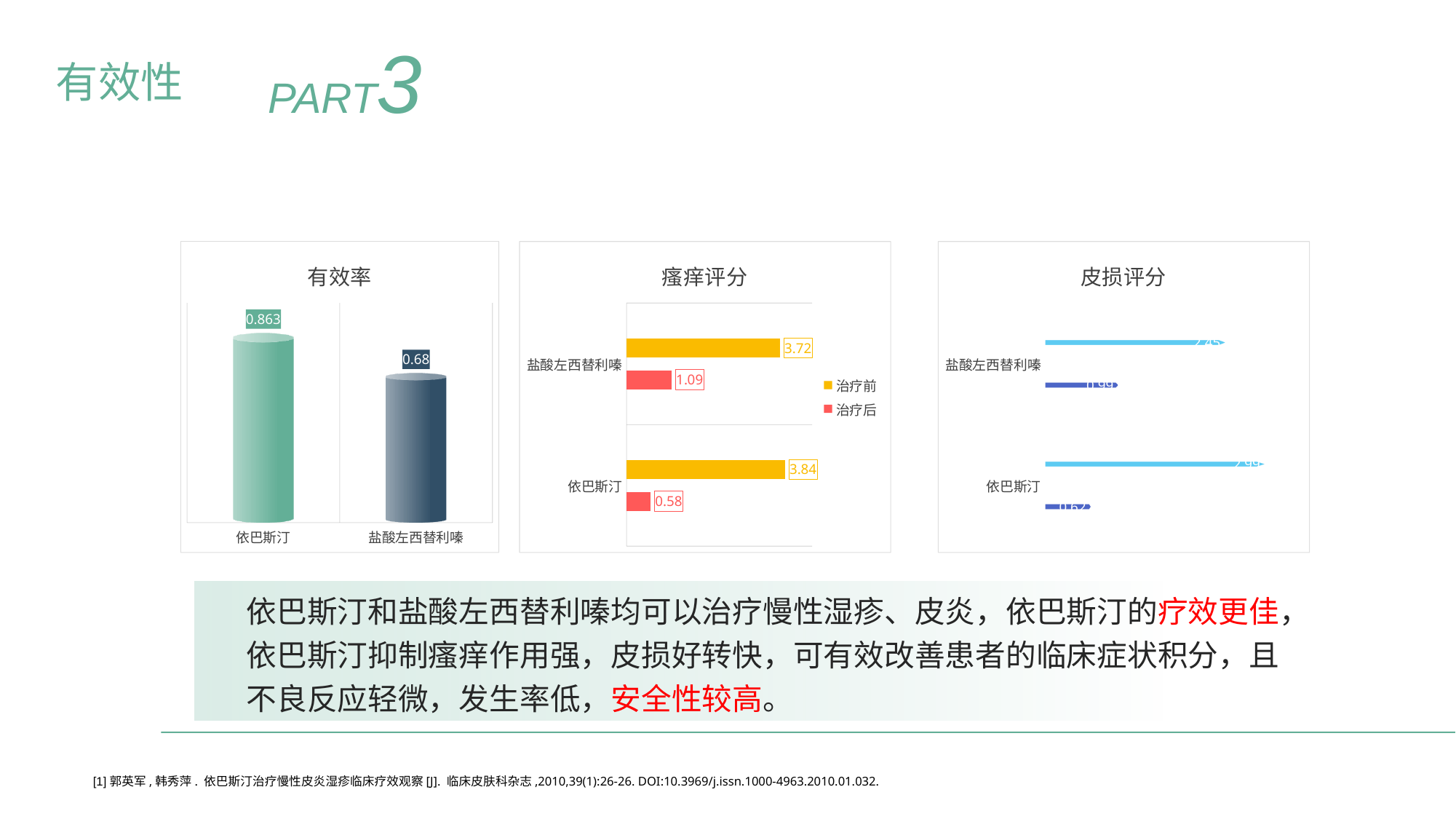
In the 有效率 chart, what is the value for 依巴斯汀? 0.863 In the 瘙痒评分 chart, what is the 治疗后 value for 盐酸左西替利嗪? 1.09 In the 瘙痒评分 chart, which colour represents 治疗前? yellow In the 瘙痒评分 chart, what is the difference between the 治疗前 and 治疗后 values for 依巴斯汀? 3.26 In the 有效率 chart, what is the difference between the values for 依巴斯汀 and 盐酸左西替利嗪? 0.183 In the 瘙痒评分 chart, how many series does the legend list? 2 In the 瘙痒评分 chart, what is the 治疗前 value for 依巴斯汀? 3.84 In the 有效率 chart, which category has the higher value? 依巴斯汀 In the 有效率 chart, what is the value for 盐酸左西替利嗪? 0.68 In the 有效率 chart, how many categories are shown? 2 In the 瘙痒评分 chart, which category has the lower 治疗后 value? 依巴斯汀 What kind of chart is the 瘙痒评分 chart? bar chart